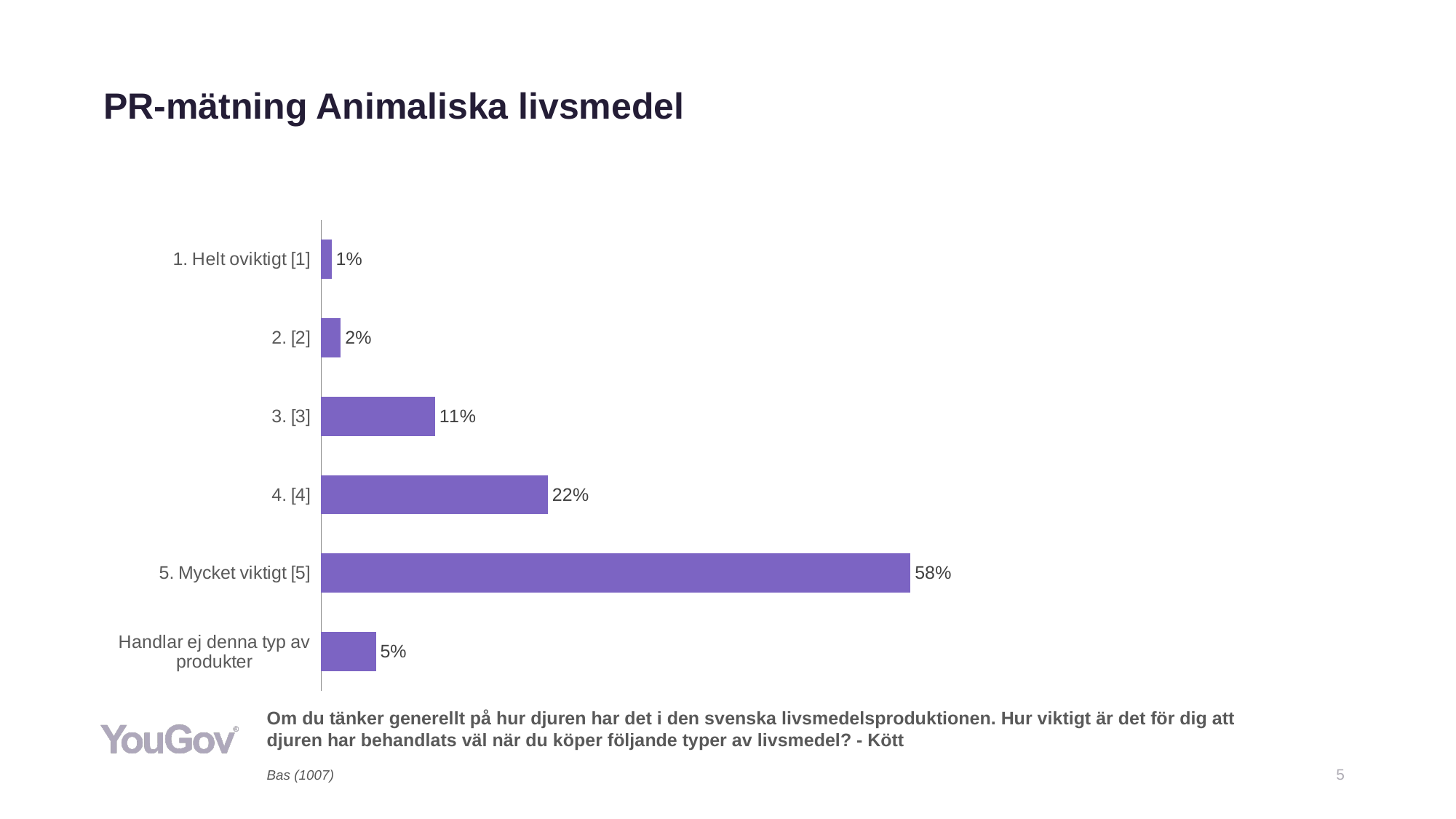
What is the value for "1. Helt oviktigt [1]"? 1% Which is larger, the value for "4. [4]" or the value for "Handlar ej denna typ av produkter"? 4. [4] What kind of chart is shown on the slide? Bar chart How many categories are shown in the chart? 6 Which category has the highest value? 5. Mycket viktigt [5] What is the difference between the values for "3. [3]" and "2. [2]"? 9% Which category has the lowest value? 1. Helt oviktigt [1] What is the title of the slide? PR-mätning Animaliska livsmedel What is the difference between the values for "5. Mycket viktigt [5]" and "4. [4]"? 36% What is the value for "5. Mycket viktigt [5]"? 58% What is the value for "Handlar ej denna typ av produkter"? 5% What is the value for "3. [3]"? 11%